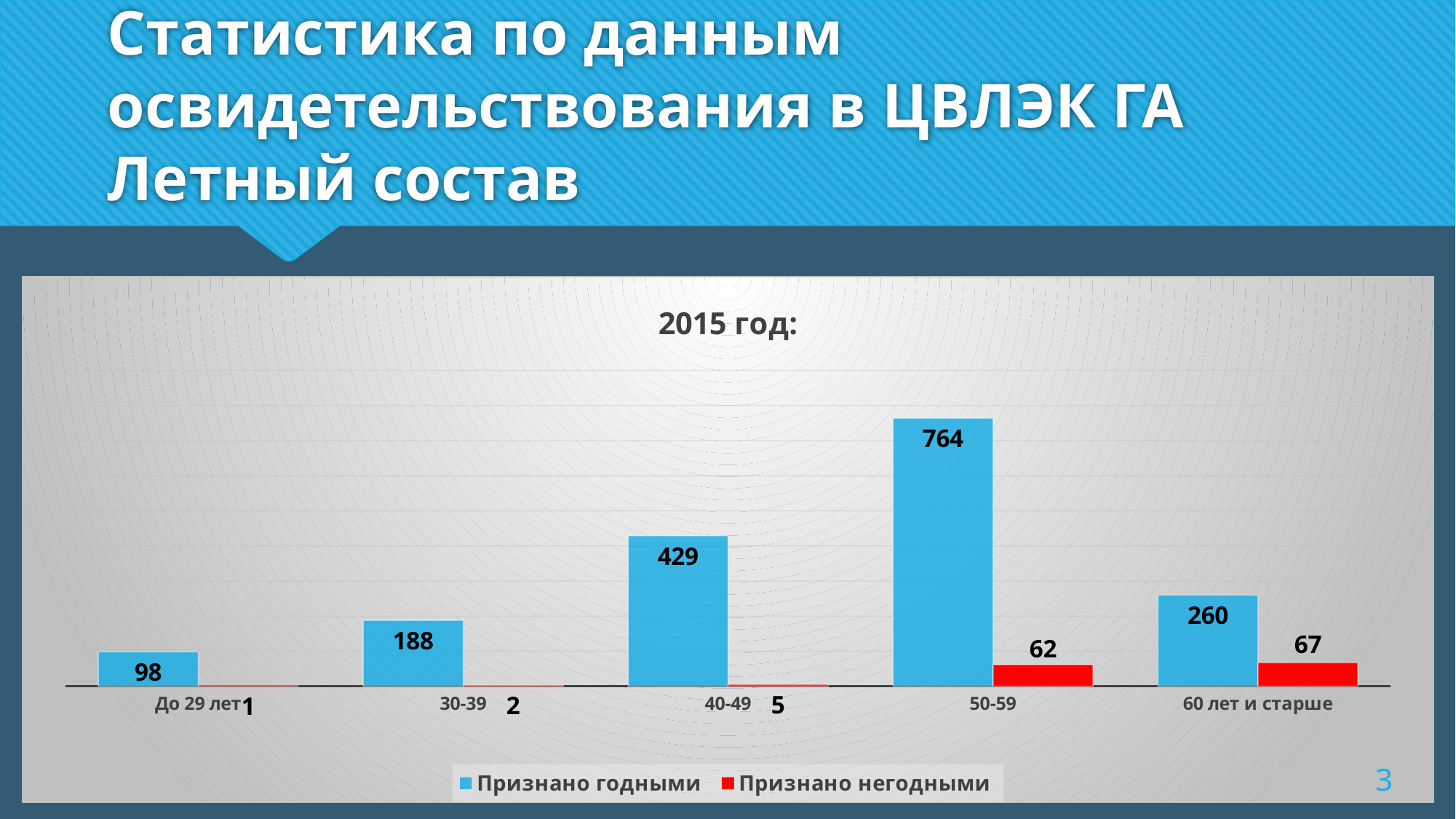
Which is larger: 'Признано годными' for 30-39 or for 60 лет и старше? 60 лет и старше Which age category has the lowest 'Признано негодными' value? До 29 лет Do the 'Признано негодными' values rise or fall from До 29 лет to 60 лет и старше? rise How many age categories are shown on the x axis? 5 What is the chart's title? 2015 год: What type of chart is shown on the slide? bar chart Which age category has the highest 'Признано годными' value? 50-59 What is the value of 'Признано годными' for the До 29 лет category? 98 How many series does the legend list? 2 What is the value of 'Признано негодными' for the 60 лет и старше category? 67 What is the difference between the 'Признано годными' values for 50-59 and 40-49? 335 What is the value of 'Признано годными' for the 50-59 category? 764